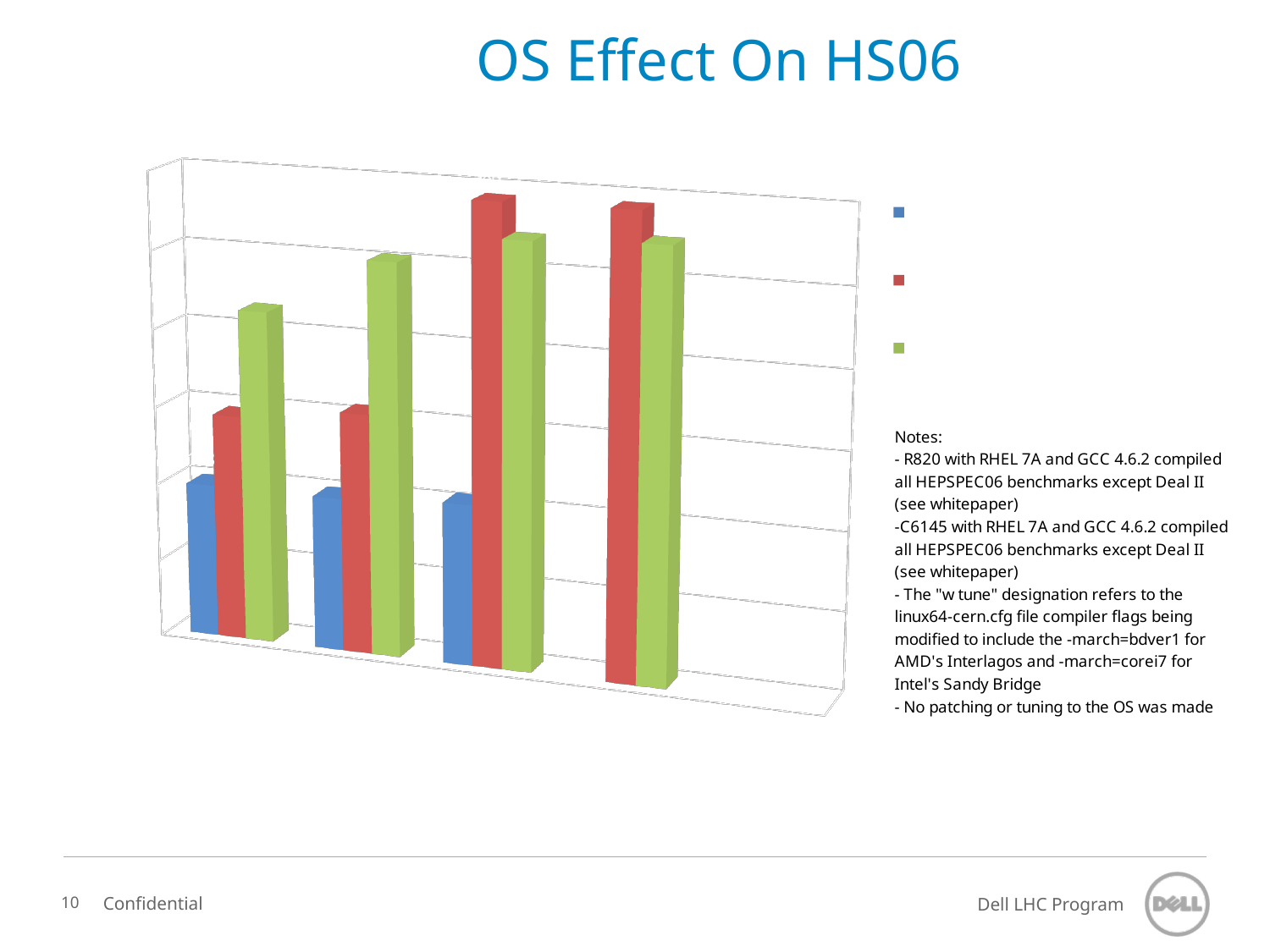
What three colours are used for the bars in the chart? blue, red and green What kind of chart is shown on the slide? bar chart How many series does the chart's legend list? 3 In the leftmost group of bars, which colour bar is the tallest? green In the third group of bars from the left, is the red bar taller or shorter than the green bar? taller What is the title of the slide containing the chart? OS Effect On HS06 In the leftmost group of bars, which colour bar is the shortest? blue How many groups of bars are plotted in the chart? 4 In the second group of bars from the left, is the blue bar taller or shorter than the red bar? shorter In the rightmost group of bars, how many bars are plotted? 2